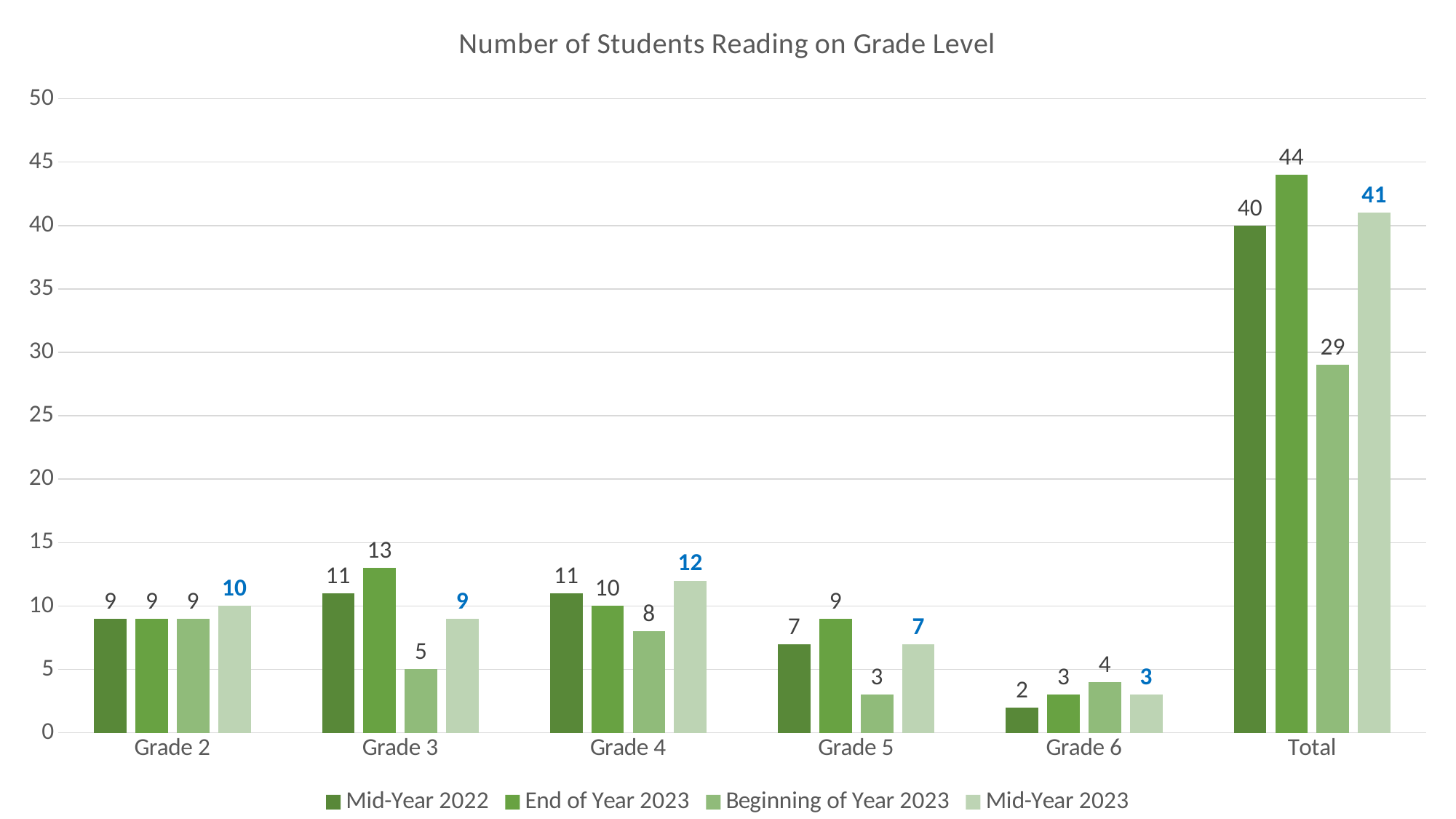
How many categories are shown on the x axis? 6 Is the Total value for Beginning of Year 2023 greater or less than 30? less What is the value for Grade 3 in the Beginning of Year 2023 series? 5 What is the value for Grade 4 in the Mid-Year 2023 series? 12 What is the difference between the End of Year 2023 and Beginning of Year 2023 values for Grade 5? 6 What is the Total value for the End of Year 2023 series? 44 What is the title of the chart? Number of Students Reading on Grade Level How many series does the legend list? 4 What kind of chart is shown on the slide? Bar chart Which grade has the lowest Mid-Year 2022 value? Grade 6 Which is larger for Grade 6: the Beginning of Year 2023 value or the Mid-Year 2023 value? Beginning of Year 2023 Which series has the highest Total value? End of Year 2023